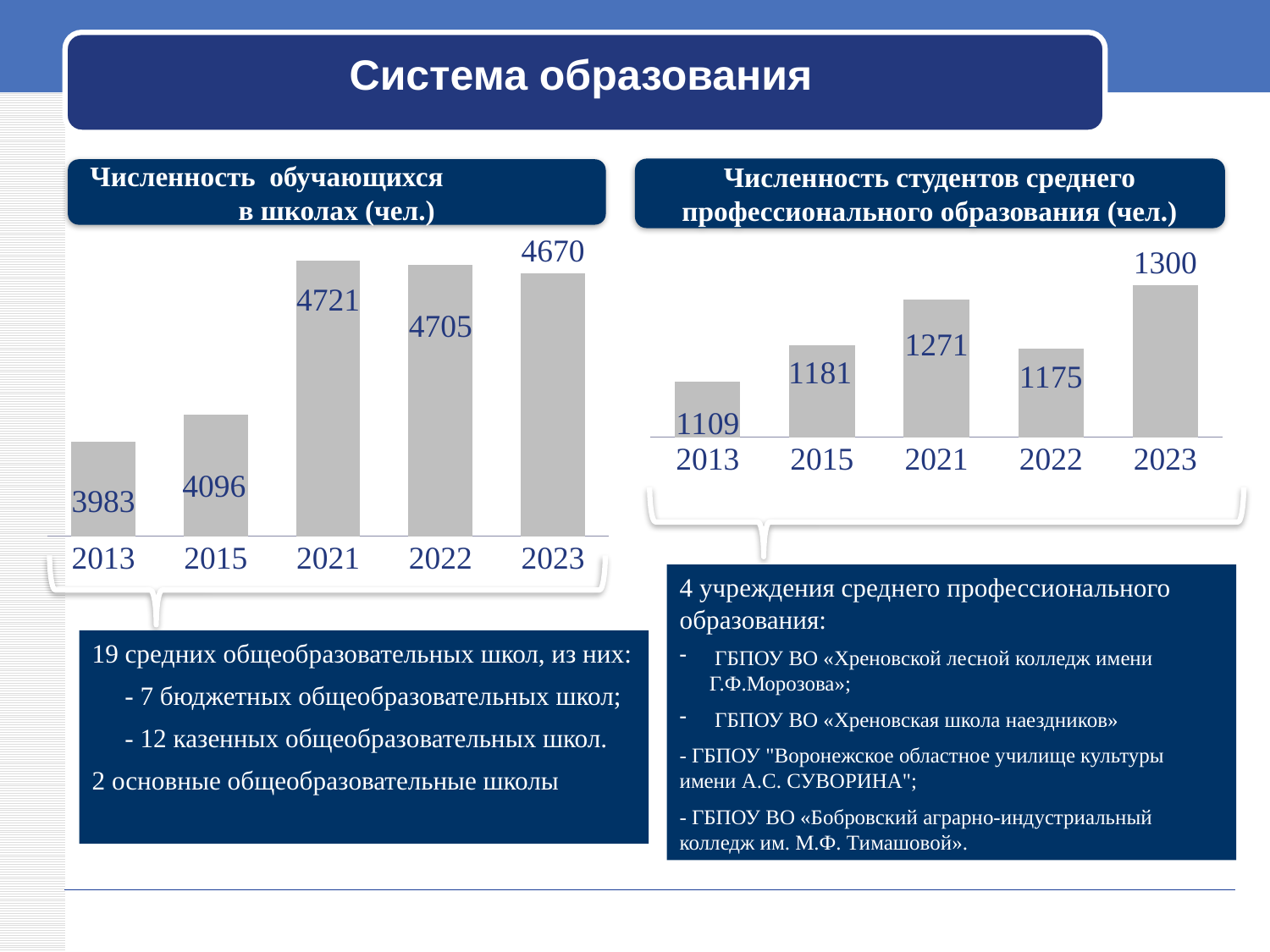
In the chart 'Численность обучающихся в школах (чел.)', what is the difference between the values for 2015 and 2013? 113 In the chart 'Численность обучающихся в школах (чел.)', what is the value for 2021? 4721 How many charts are on the slide? 2 In the chart 'Численность студентов среднего профессионального образования (чел.)', what is the value for 2022? 1175 In the chart 'Численность студентов среднего профессионального образования (чел.)', which year has the highest value? 2023 In the chart 'Численность обучающихся в школах (чел.)', is the value for 2022 larger or smaller than the value for 2023? larger What kind of chart is 'Численность обучающихся в школах (чел.)'? bar chart In the chart 'Численность студентов среднего профессионального образования (чел.)', which is larger, the value for 2021 or the value for 2015? 2021 In the chart 'Численность обучающихся в школах (чел.)', which year has the lowest value? 2013 In the chart 'Численность студентов среднего профессионального образования (чел.)', what is the value for 2013? 1109 In the chart 'Численность студентов среднего профессионального образования (чел.)', what is the difference between the values for 2023 and 2013? 191 In the chart 'Численность обучающихся в школах (чел.)', how many years are shown on the x axis? 5